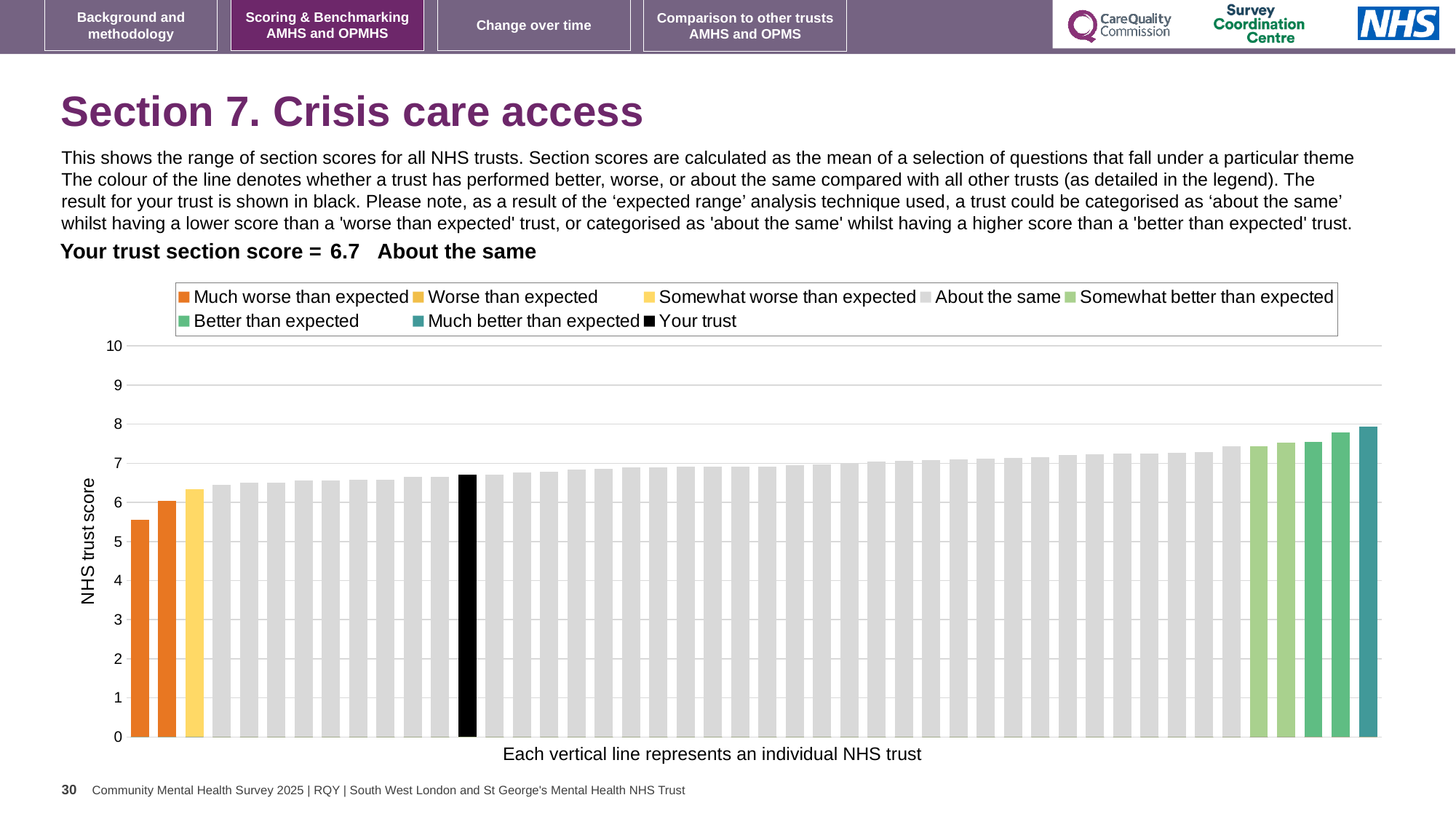
What colour is the bar representing your trust? black Which category is your trust placed in for this section? About the same Is the value for your trust greater or less than 6? greater How many entries does the chart legend list? 8 What is the section score for your trust? 6.7 Which legend category does the tallest bar belong to? Much better than expected What kind of chart is shown on the slide? bar chart Is the lowest bar on the chart greater or less than 5? greater How many bars are coloured as 'Much worse than expected'? 2 Do the bar values rise or fall from left to right along the x axis? rise Which legend category does the shortest bar belong to? Much worse than expected